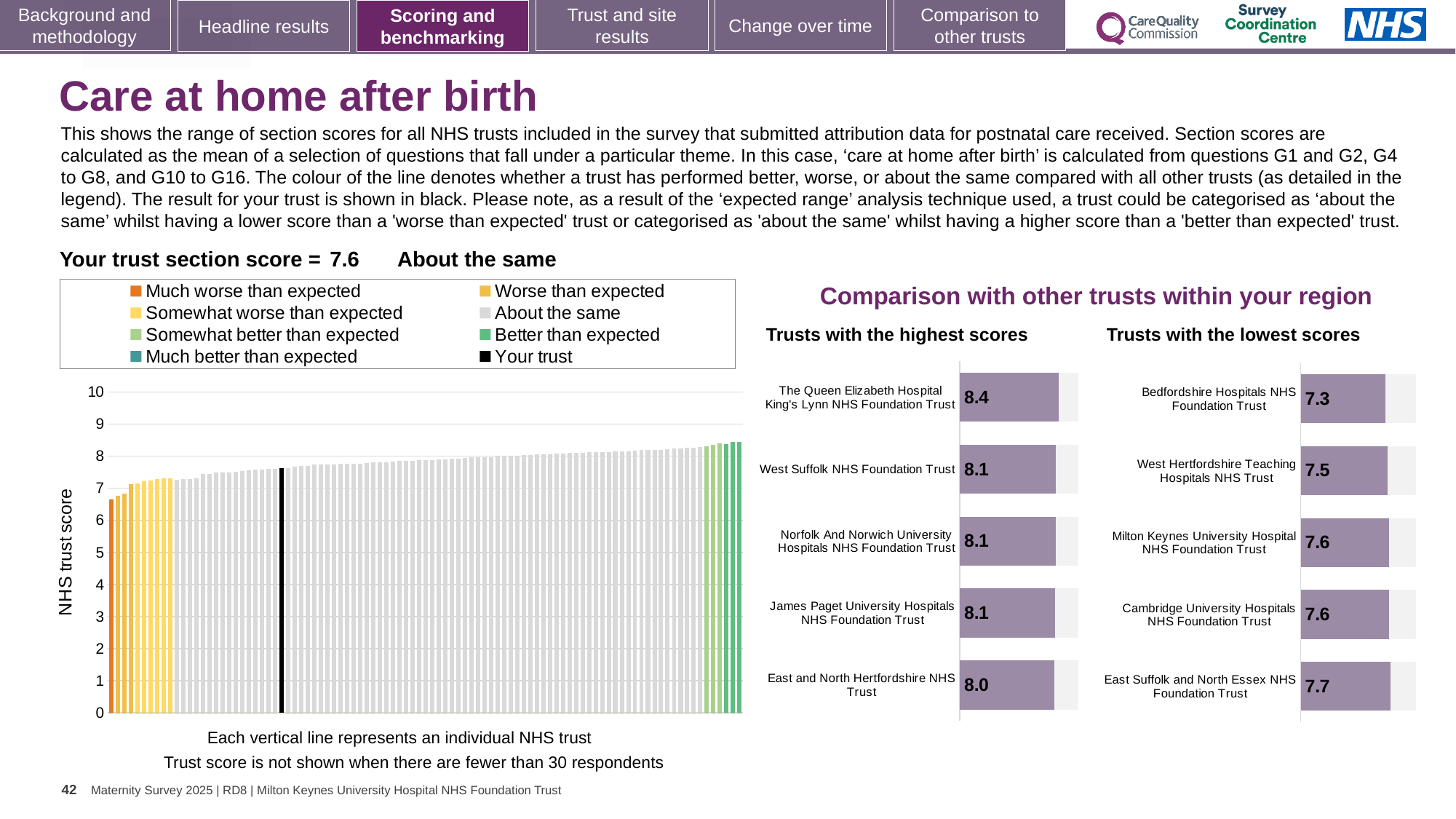
In the 'Trusts with the highest scores' chart, what is the score for The Queen Elizabeth Hospital King's Lynn NHS Foundation Trust? 8.4 In the 'Trusts with the lowest scores' chart, which has the larger score: West Hertfordshire Teaching Hospitals NHS Trust or Bedfordshire Hospitals NHS Foundation Trust? West Hertfordshire Teaching Hospitals NHS Trust In the 'Trusts with the lowest scores' chart, what is the difference between the scores of East Suffolk and North Essex NHS Foundation Trust and Bedfordshire Hospitals NHS Foundation Trust? 0.4 In the 'Trusts with the highest scores' chart, which trust has the lowest score? East and North Hertfordshire NHS Trust In the 'Trusts with the lowest scores' chart, what is the score for Bedfordshire Hospitals NHS Foundation Trust? 7.3 In the 'Trusts with the lowest scores' chart, which trust has the highest score? East Suffolk and North Essex NHS Foundation Trust In the 'Trusts with the lowest scores' chart, what is the score for Milton Keynes University Hospital NHS Foundation Trust? 7.6 In the 'Trusts with the highest scores' chart, how many trusts are shown? 5 How many entries does the legend above the large chart on the left list? 8 In the 'Trusts with the highest scores' chart, what is the difference between the scores of The Queen Elizabeth Hospital King's Lynn NHS Foundation Trust and East and North Hertfordshire NHS Trust? 0.4 What kind of chart is the large chart on the left showing NHS trust scores? Bar chart In the large chart on the left, do the trust scores rise or fall from left to right? Rise